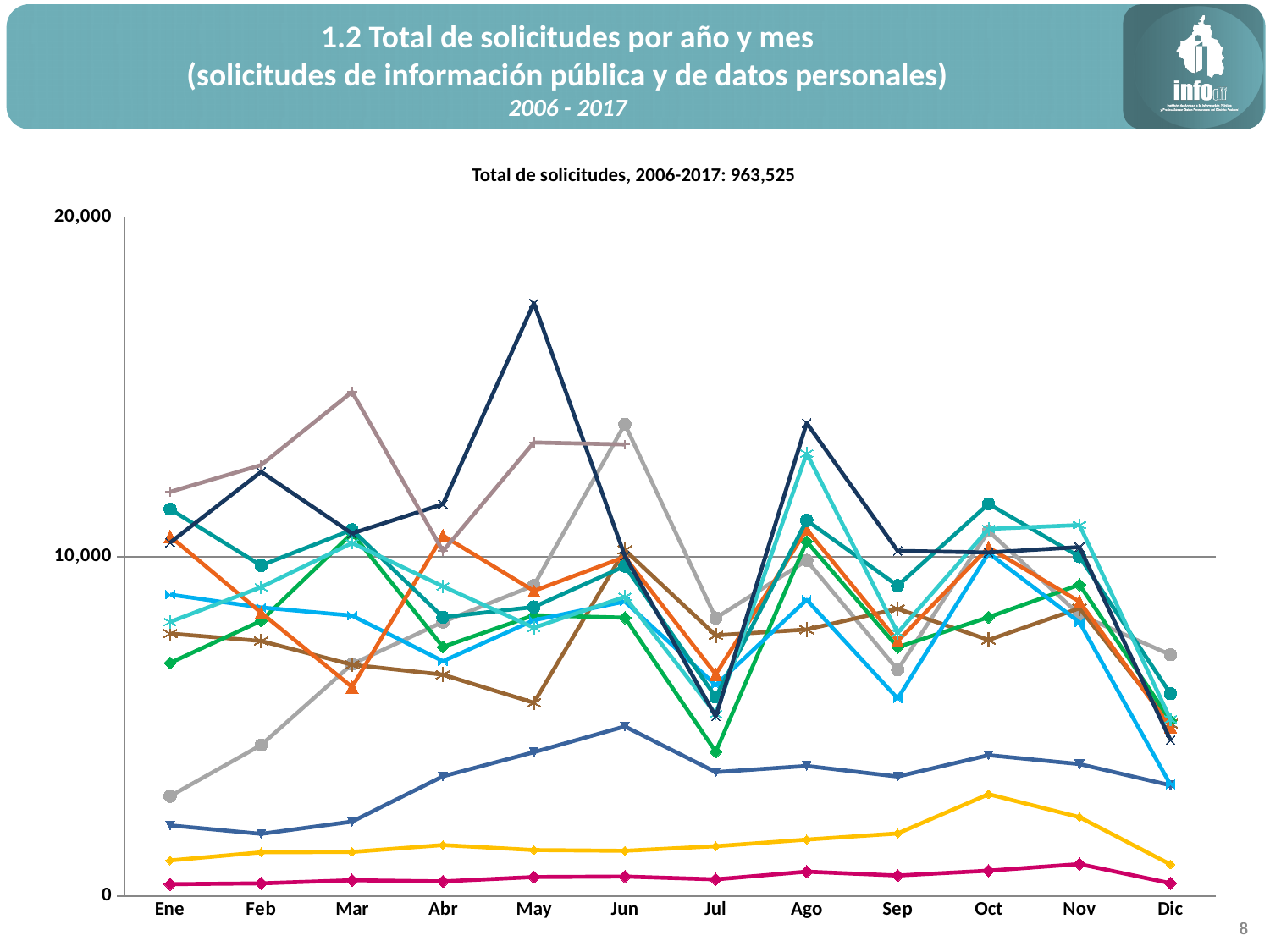
How many months are shown along the x axis of the chart? 12 What is the last month label on the x axis? Dic What is the maximum value shown on the y axis of the chart? 20,000 In which month does the chart reach its single highest plotted point? May Is the highest point plotted in May greater or less than 20,000? less What is the first month label on the x axis? Ene Is the highest point plotted in May greater or less than 10,000? greater According to the chart title, what is the total number of solicitudes for 2006-2017? 963,525 What is the title printed above the chart? Total de solicitudes, 2006-2017: 963,525 What kind of chart is shown on the slide? line chart Is the lowest point plotted in Dic greater or less than 10,000? less